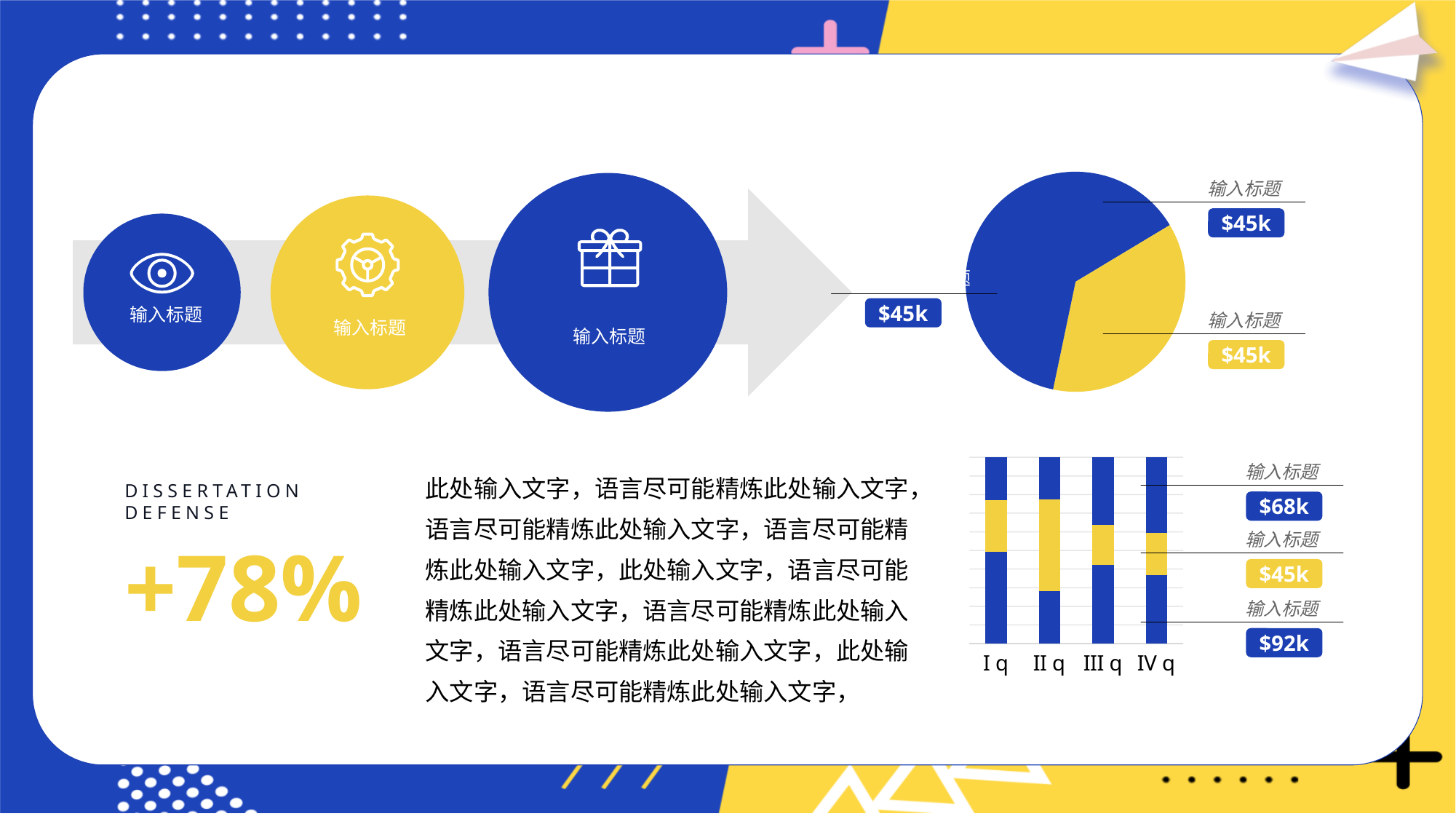
Which two colours are used for the slices of the pie chart? blue and yellow What kind of chart is shown in the bottom right of the slide? bar chart What is the difference between the $92k and $68k callout values next to the bar chart? $24k How many categories are shown on the x axis of the bar chart? 4 What kind of chart is shown in the top right of the slide? pie chart What are the category labels on the x axis of the bar chart? Ⅰq, Ⅱq, Ⅲq, Ⅳq In the bar chart, which category has the largest yellow segment? Ⅱq What value is shown in the callout for the yellow slice of the pie chart? $45k What is the largest value shown in the callouts next to the bar chart? $92k How many segments does each bar in the bar chart contain? 3 What is the smallest value shown in the callouts next to the bar chart? $45k